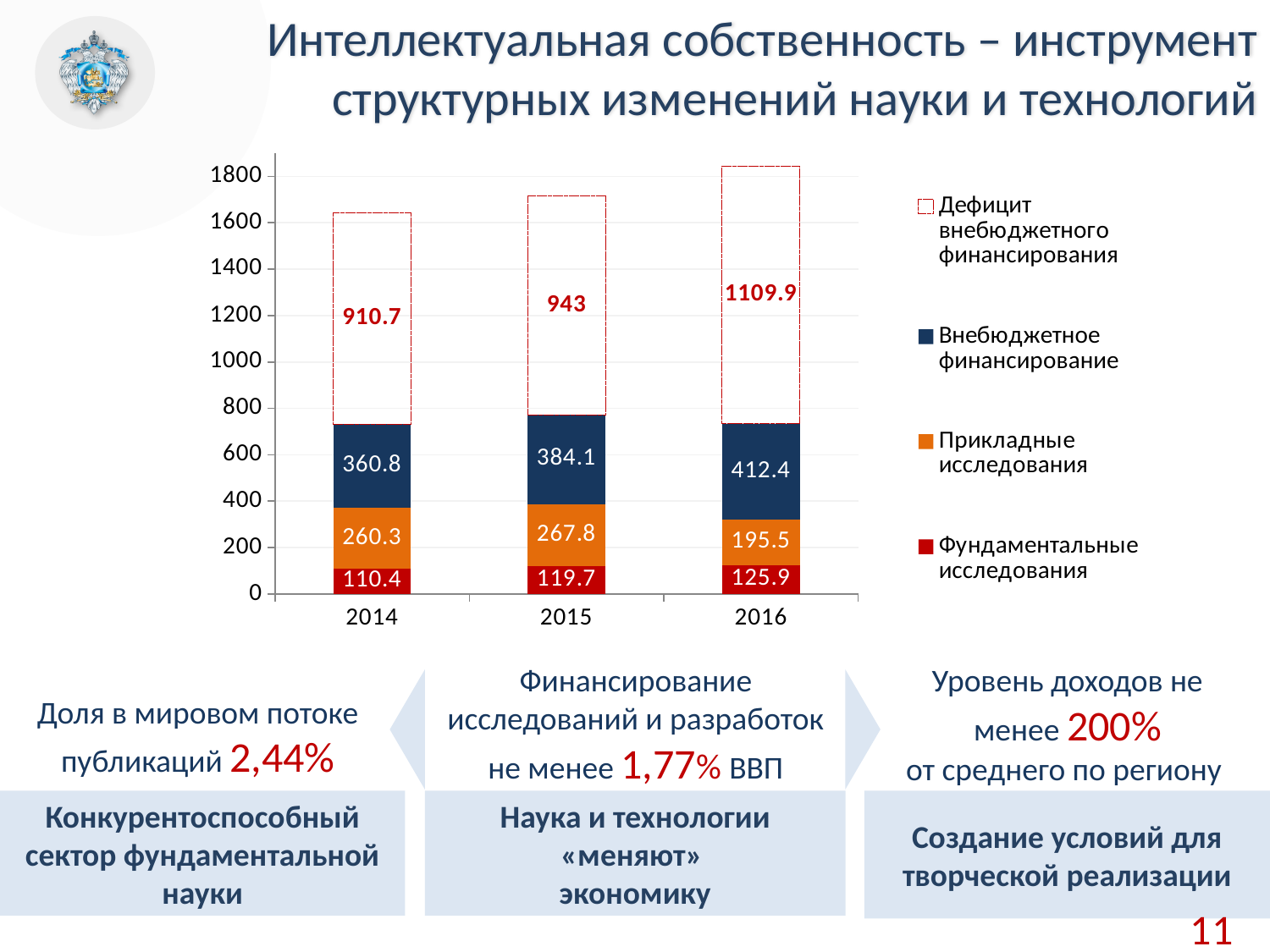
What is the difference between the Внебюджетное финансирование values for 2016 and 2014? 51.6 How many years are shown on the x axis of the chart? 3 What is the value of Фундаментальные исследования for 2015? 119.7 How many series does the chart legend list? 4 What is the value of Внебюджетное финансирование for 2016? 412.4 Do the values of Фундаментальные исследования rise or fall from 2014 to 2016? Rise In which year is the value of Дефицит внебюджетного финансирования highest? 2016 What is the value of Дефицит внебюджетного финансирования for 2014? 910.7 In which year is the value of Прикладные исследования lowest? 2016 What type of chart is shown on the slide? Stacked bar chart What is the total of the stacked bar for 2014? 1642.2 Which is larger: Прикладные исследования in 2015 or Прикладные исследования in 2016? 2015